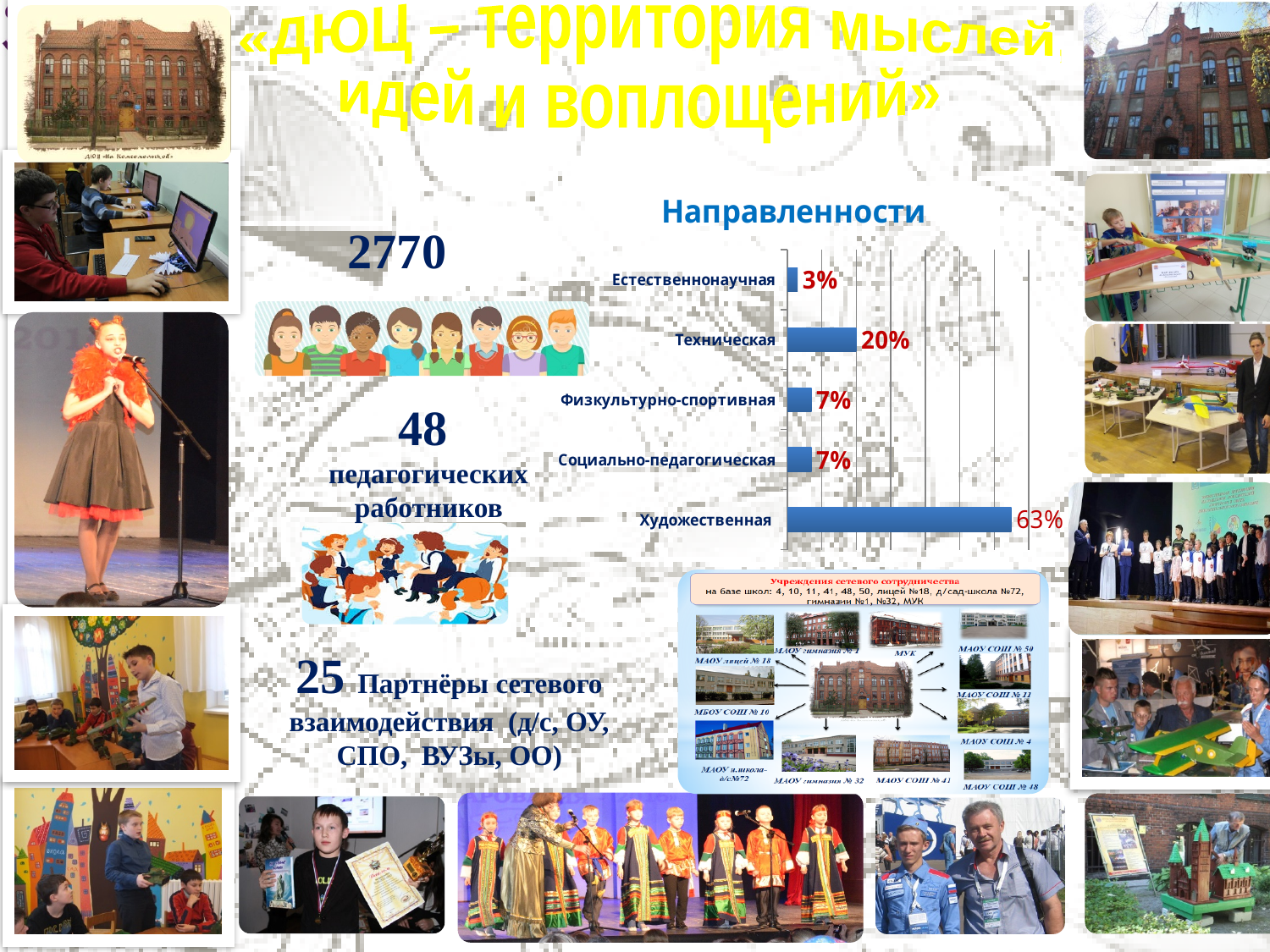
What is the value for Социально-педагогическая in the "Направленности" chart? 7% What is the value for Художественная in the "Направленности" chart? 63% What type of chart is shown under the title "Направленности"? bar chart What is the title of the bar chart on the slide? Направленности In the "Направленности" chart, what is the difference between the values for Художественная and Техническая? 43% How many categories are shown in the "Направленности" chart? 5 What is the value for Естественнонаучная in the "Направленности" chart? 3% What is the value for Физкультурно-спортивная in the "Направленности" chart? 7% Which category has the highest value in the "Направленности" chart? Художественная In the "Направленности" chart, which is larger: Техническая or Физкультурно-спортивная? Техническая What is the value for Техническая in the "Направленности" chart? 20% Which category has the lowest value in the "Направленности" chart? Естественнонаучная